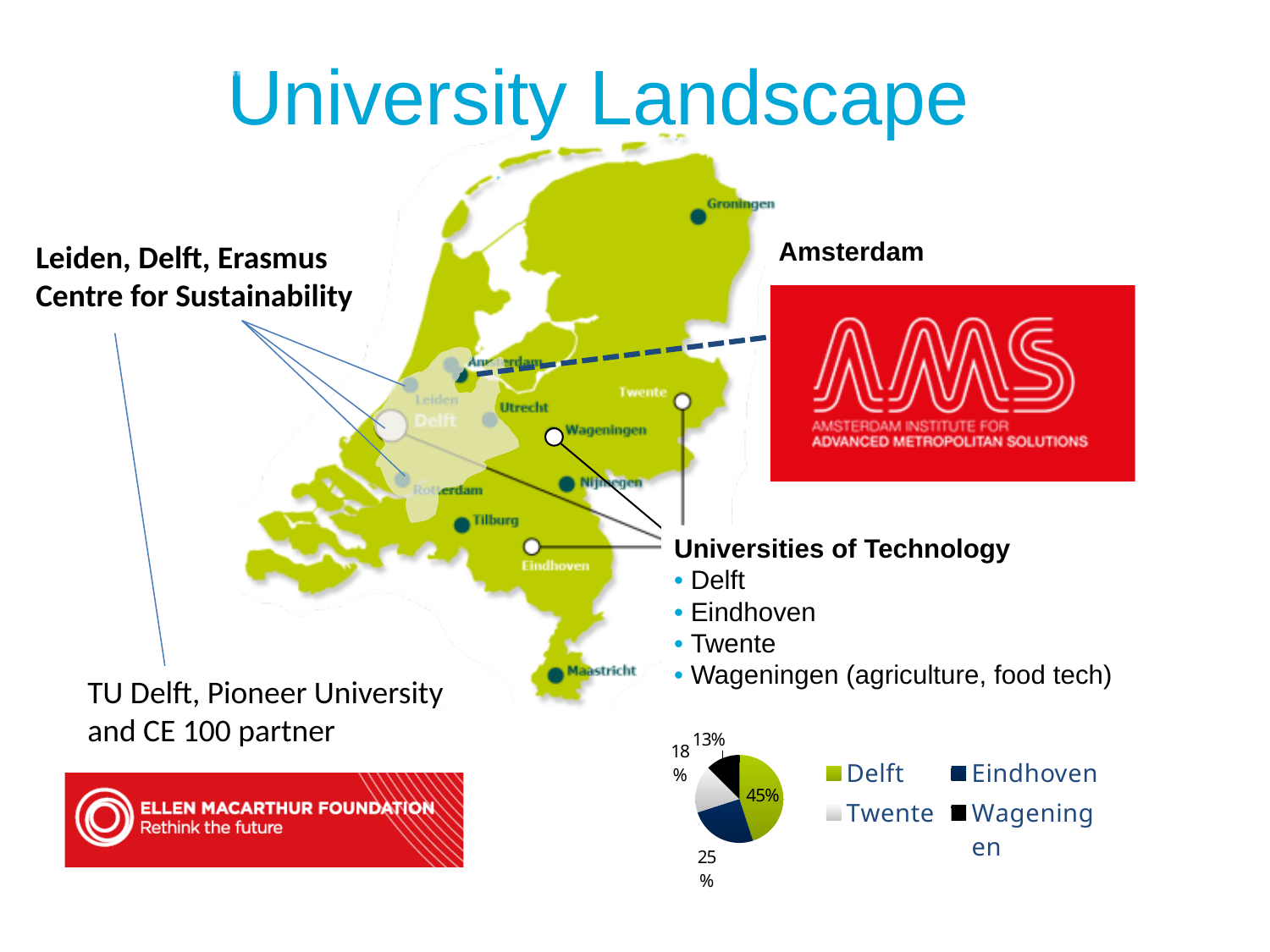
How many entries does the pie chart's legend list? 4 In the pie chart, what share does Eindhoven have? 25% What colour is the Delft slice in the pie chart? green In the pie chart, how many percentage points larger is Delft's share than Eindhoven's? 20 How many slices does the pie chart have? 4 Which university has the smallest slice in the pie chart? Wageningen In the pie chart, what share does Delft have? 45% What kind of chart is shown at the bottom of the slide? pie chart In the pie chart, what share does Wageningen have? 13% In the pie chart, which has the larger share, Twente or Eindhoven? Eindhoven Which university has the largest slice in the pie chart? Delft In the pie chart, what share does Twente have? 18%